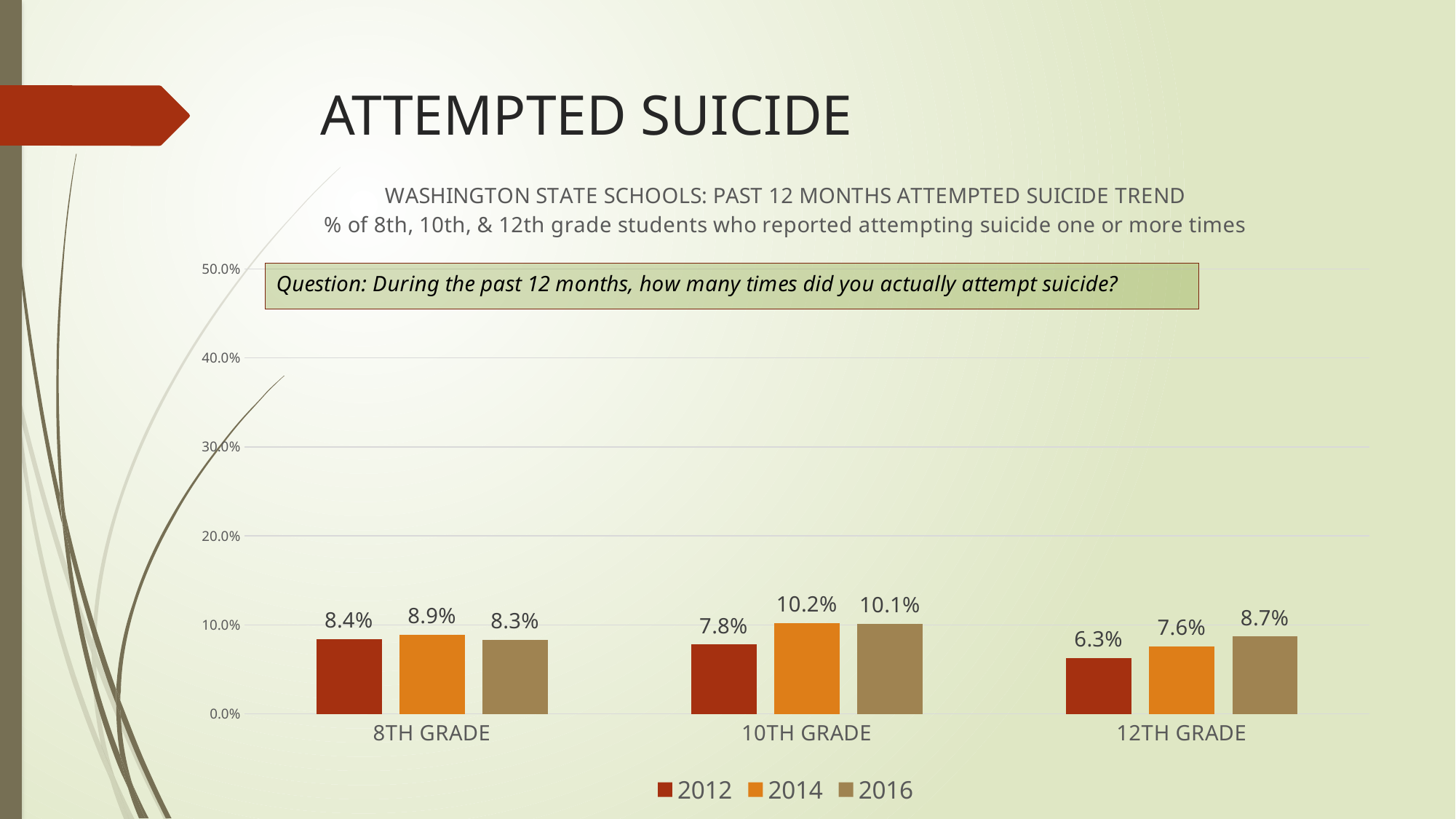
Is the value for 10th grade in 2014 greater or less than 10.0%? greater What kind of chart is shown on the slide? Bar chart What is the value for 10th grade in 2016? 10.1% How many series does the legend list? 3 What is the difference between the 2016 and 2012 values for 12th grade? 2.4% Which is larger for 10th grade: the 2014 value or the 2012 value? 2014 What percentage of 8th grade students reported attempting suicide in 2014? 8.9% Do the values for 12th grade rise or fall from 2012 to 2016? Rise How many grade categories are shown on the x axis? 3 What is the value for 12th grade in 2012? 6.3% Which grade has the highest value in 2014? 10th grade Which grade has the lowest value in 2012? 12th grade